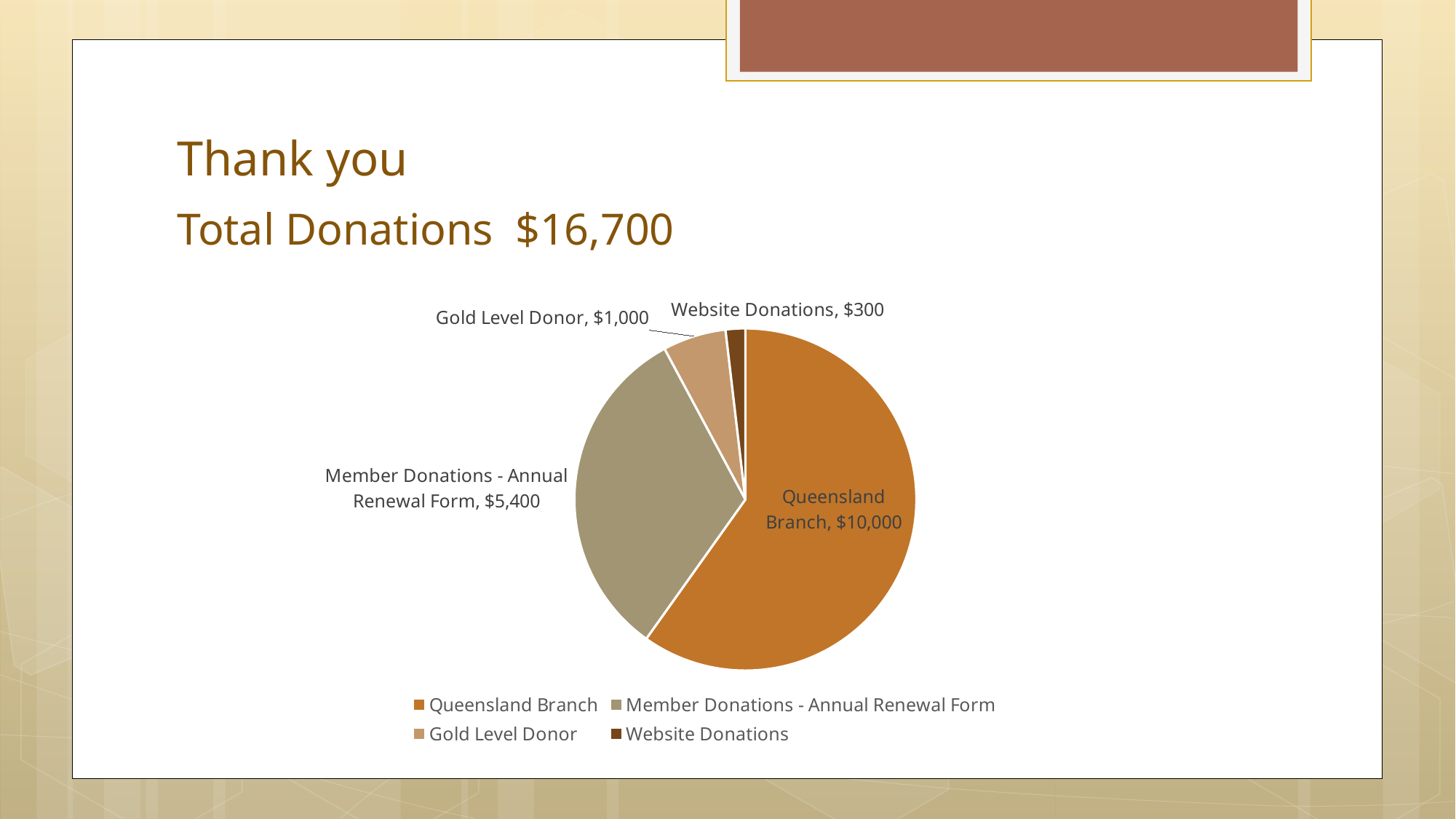
How many slices does the pie chart have? 4 What total donations figure is stated in the slide title? $16,700 What is the difference between the Queensland Branch value and the Member Donations - Annual Renewal Form value? $4,600 What is the value for Website Donations? $300 What kind of chart is shown on the slide? Pie chart Which is larger, Gold Level Donor or Website Donations? Gold Level Donor What is the value for Gold Level Donor? $1,000 Which category has the largest slice of the pie? Queensland Branch Which category has the smallest slice of the pie? Website Donations What is the total of all the slices in the pie chart? $16,700 What is the value for Queensland Branch? $10,000 What is the value for Member Donations - Annual Renewal Form? $5,400